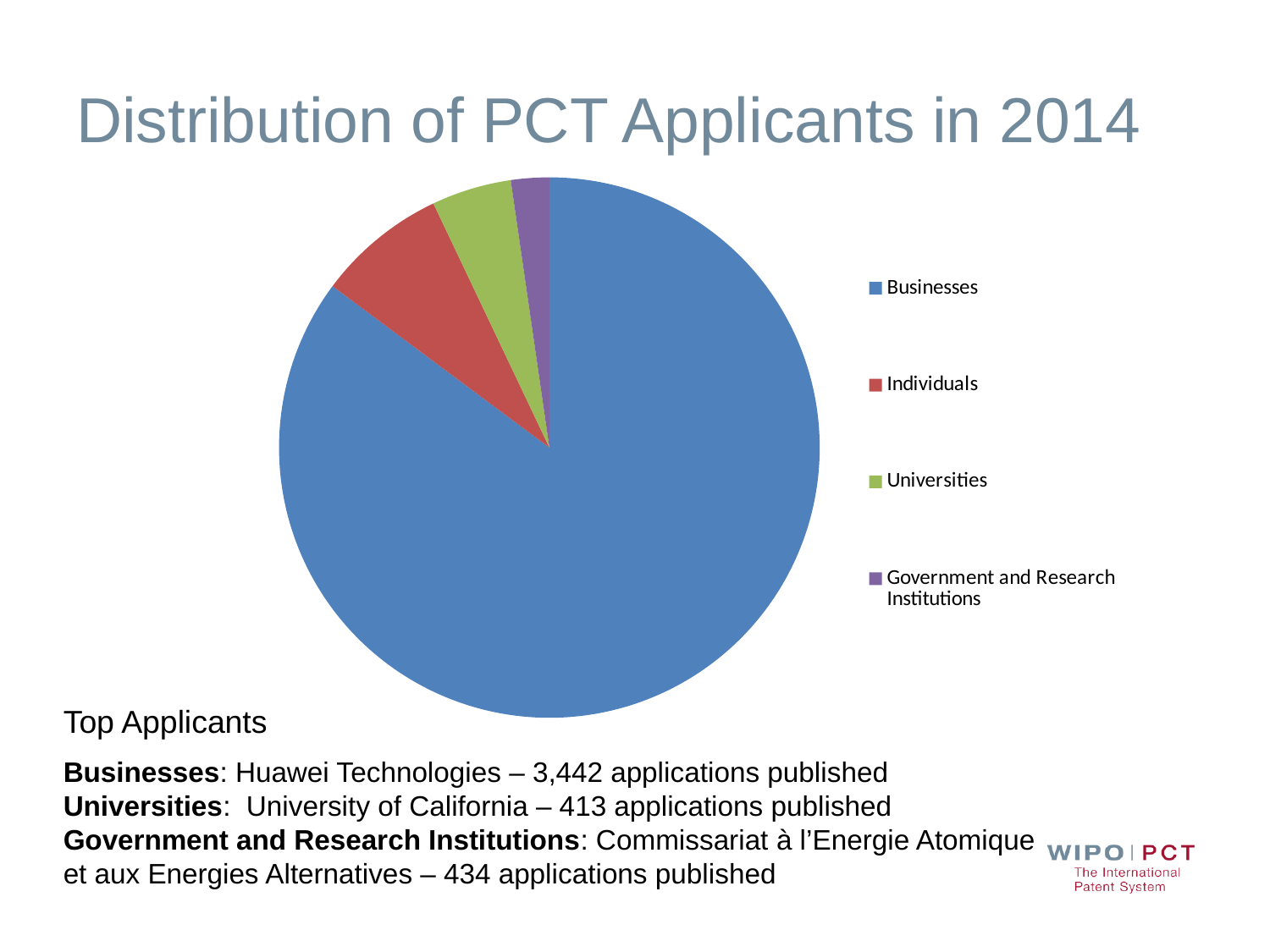
Which slice is larger, Individuals or Universities? Individuals Which category is shown in blue in the pie chart? Businesses Which category is listed last in the chart legend? Government and Research Institutions Which category has the smallest slice of the pie? Government and Research Institutions Which slice is larger, Businesses or Individuals? Businesses Which slice is larger, Universities or Government and Research Institutions? Universities Which category has the largest slice of the pie? Businesses How many categories does the pie chart show? 4 What kind of chart is shown on the slide? Pie chart What is the title of the chart on the slide? Distribution of PCT Applicants in 2014